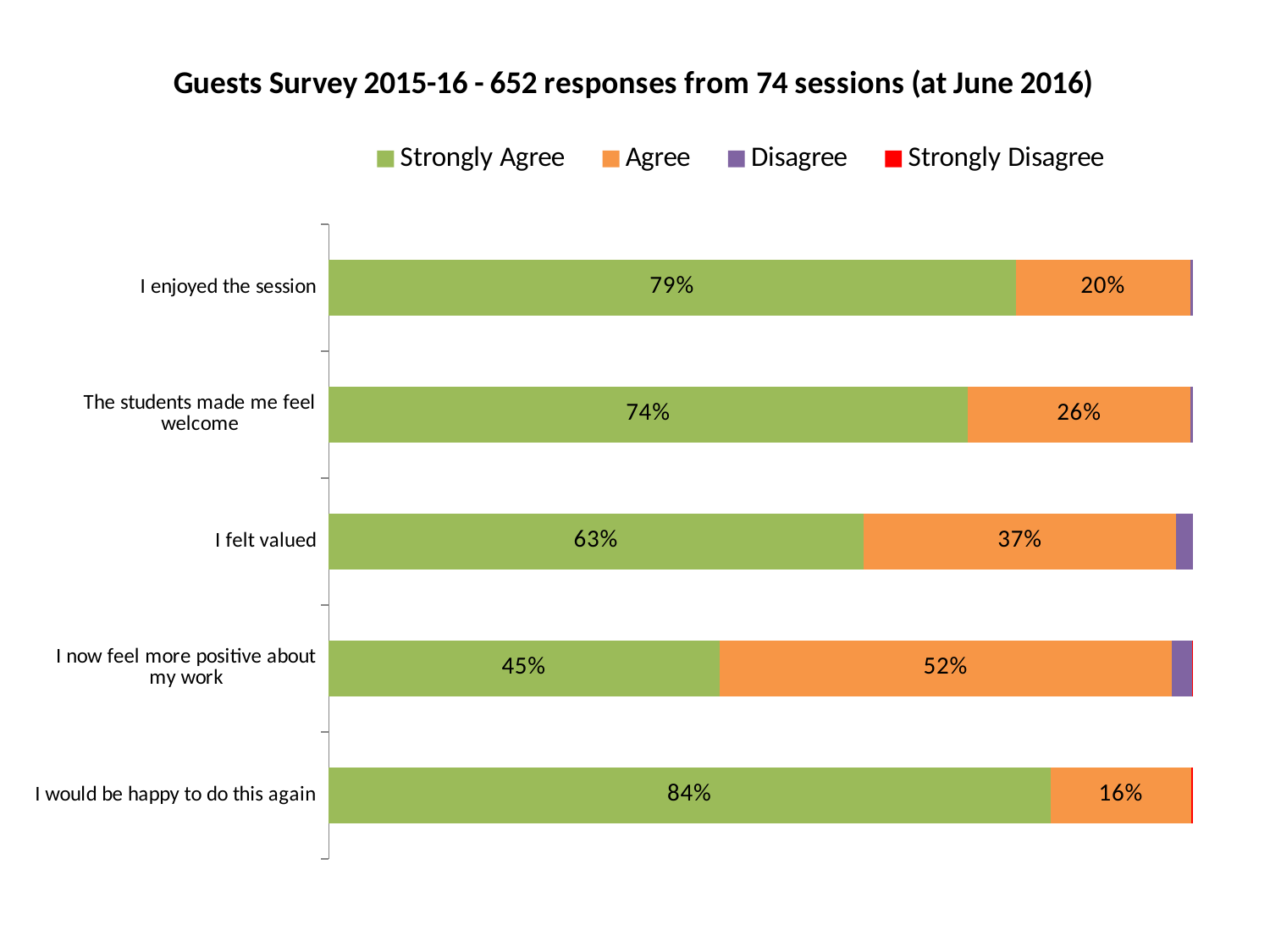
What is the Agree value for 'The students made me feel welcome'? 26% How many statements (categories) are shown on the chart? 5 What is the difference between the Strongly Agree values for 'I would be happy to do this again' and 'I felt valued'? 21% Which colour represents the Agree series in the legend? Orange What kind of chart is shown on the slide? Stacked bar chart Which statement has the highest Strongly Agree value? I would be happy to do this again What is the Agree value for 'I now feel more positive about my work'? 52% Which is larger for 'I felt valued': the Strongly Agree value or the Agree value? Strongly Agree Which statement has the lowest Strongly Agree value? I now feel more positive about my work What is the title of the chart? Guests Survey 2015-16 - 652 responses from 74 sessions (at June 2016) How many series does the legend list? 4 What is the Strongly Agree value for 'I enjoyed the session'? 79%